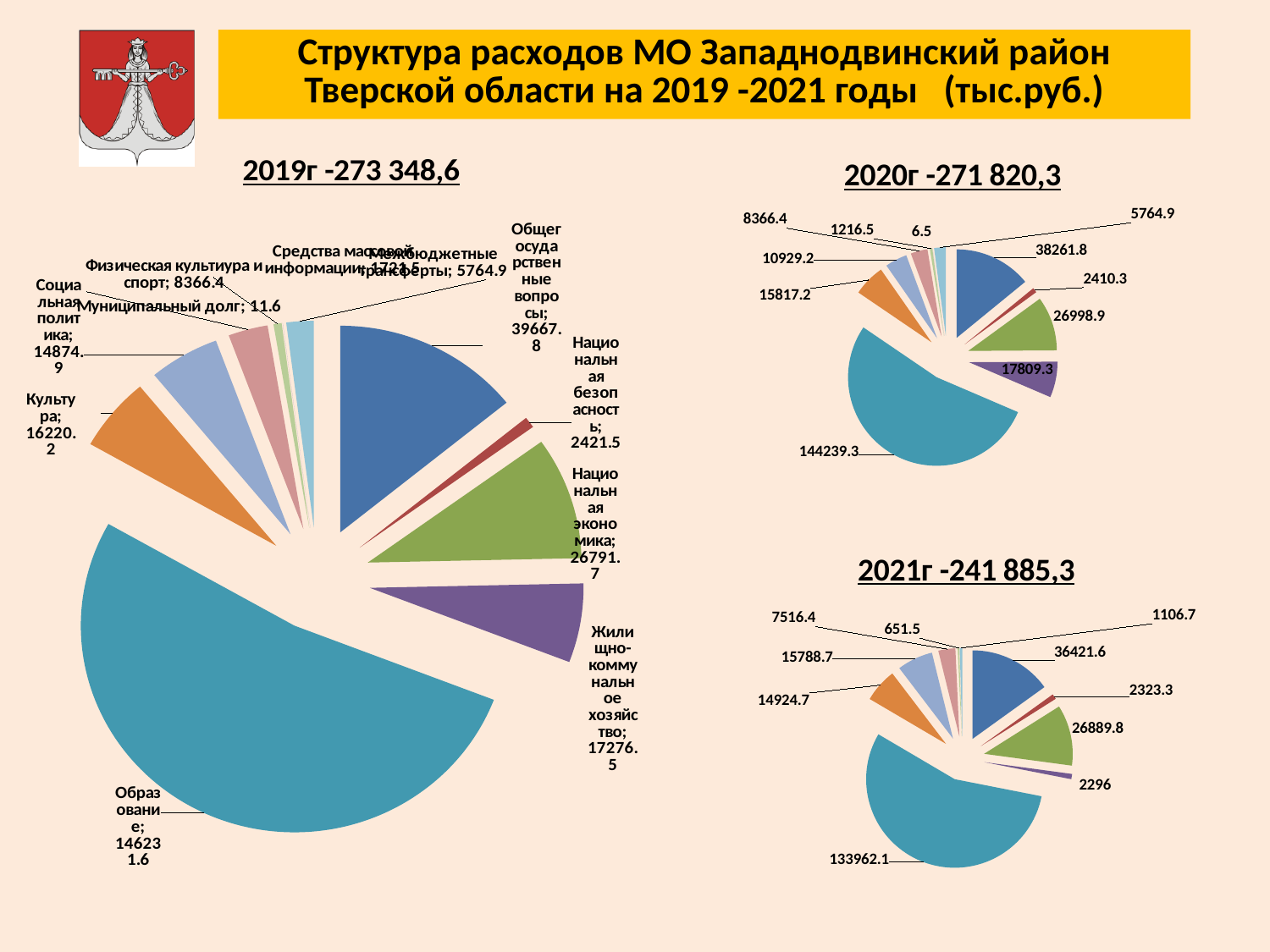
In the 2019 chart, what is the value for Образование? 146231.6 In the 2020 chart, what is the value of the largest slice? 144239.3 In the 2019 chart, which is larger: Культура or Социальная политика? Культура In the 2019 chart, which category has the largest slice? Образование In the 2019 chart, what is the value for Национальная экономика? 26791.7 In the 2020 chart, what is the value of the smallest slice? 6.5 What kind of chart is used on this slide to show the expenditure structure? Pie chart In the 2021 chart, what is the value of the largest slice? 133962.1 In the 2019 chart, what is the value for Жилищно-коммунальное хозяйство? 17276.5 In the 2019 chart, which category has the smallest value? Муниципальный долг How many pie charts are shown on the slide? 3 In the 2019 chart, what is the difference between Общегосударственные вопросы and Национальная безопасность? 37246.3